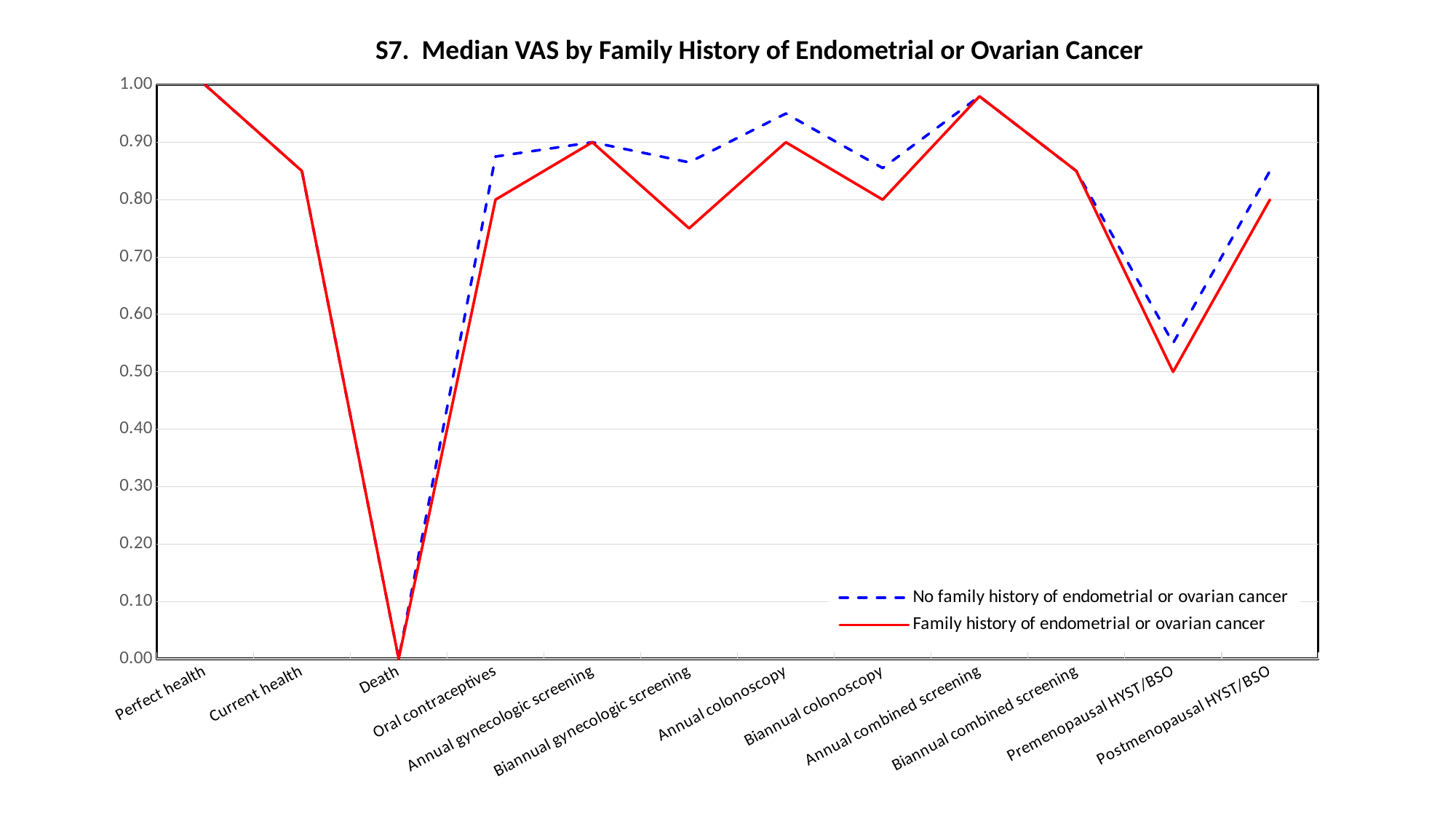
What kind of chart is shown on the slide? Line chart Do the values rise or fall from Perfect health to Death? Fall How many series does the legend list? 2 Which category has the lowest value for both series? Death How many categories are shown along the x axis? 12 Which category has the highest value for both series? Perfect health Which series is drawn with a dashed blue line? No family history of endometrial or ovarian cancer What is the value for Death for the Family history of endometrial or ovarian cancer series? 0.00 What is the value for Premenopausal HYST/BSO for the Family history of endometrial or ovarian cancer series? 0.50 Is the value for Biannual gynecologic screening for the No family history series greater or less than 0.80? greater For Annual colonoscopy, which series has the larger value: No family history or Family history of endometrial or ovarian cancer? No family history of endometrial or ovarian cancer Is the value for Premenopausal HYST/BSO for the No family history series greater or less than 0.60? less